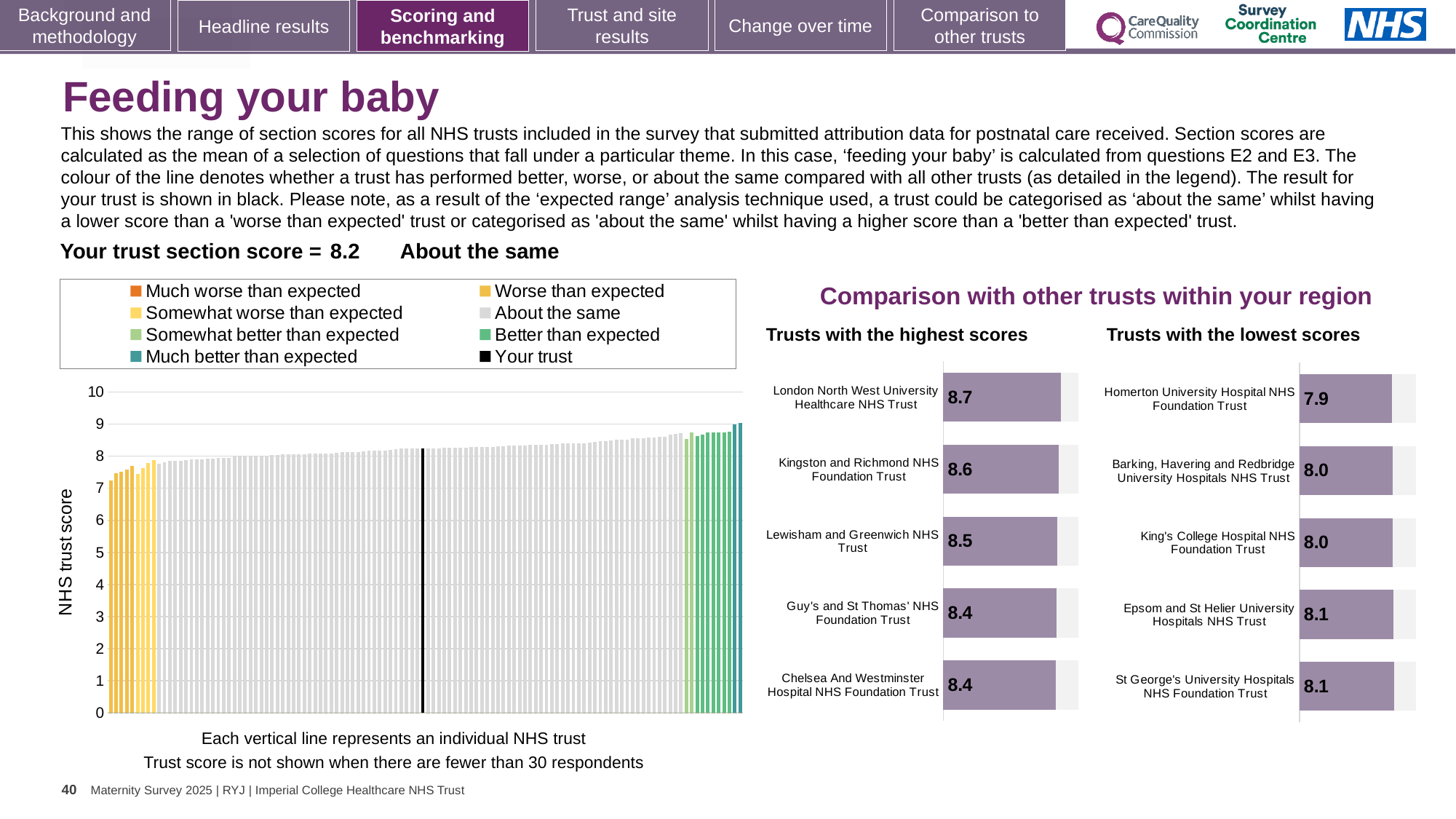
In the NHS trust score chart, is the value of the leftmost bar greater or less than 8? less In the 'Trusts with the highest scores' chart, which trust has the highest score? London North West University Healthcare NHS Trust How many trusts are shown in the 'Trusts with the lowest scores' chart? 5 What is the difference between the score for London North West University Healthcare NHS Trust in the highest scores chart and the score for Homerton University Hospital NHS Foundation Trust in the lowest scores chart? 0.8 What kind of chart is the NHS trust score chart on the left of the slide? Bar chart In the 'Trusts with the lowest scores' chart, what is the score for Homerton University Hospital NHS Foundation Trust? 7.9 In the 'Trusts with the lowest scores' chart, which trust has the lowest score? Homerton University Hospital NHS Foundation Trust How many entries does the legend of the NHS trust score chart list? 8 In the 'Trusts with the lowest scores' chart, what is the score for Epsom and St Helier University Hospitals NHS Trust? 8.1 In the 'Trusts with the highest scores' chart, what is the score for Lewisham and Greenwich NHS Trust? 8.5 In the 'Trusts with the highest scores' chart, which has the larger score: Kingston and Richmond NHS Foundation Trust or Guy's and St Thomas' NHS Foundation Trust? Kingston and Richmond NHS Foundation Trust In the 'Trusts with the highest scores' chart, what is the score for London North West University Healthcare NHS Trust? 8.7